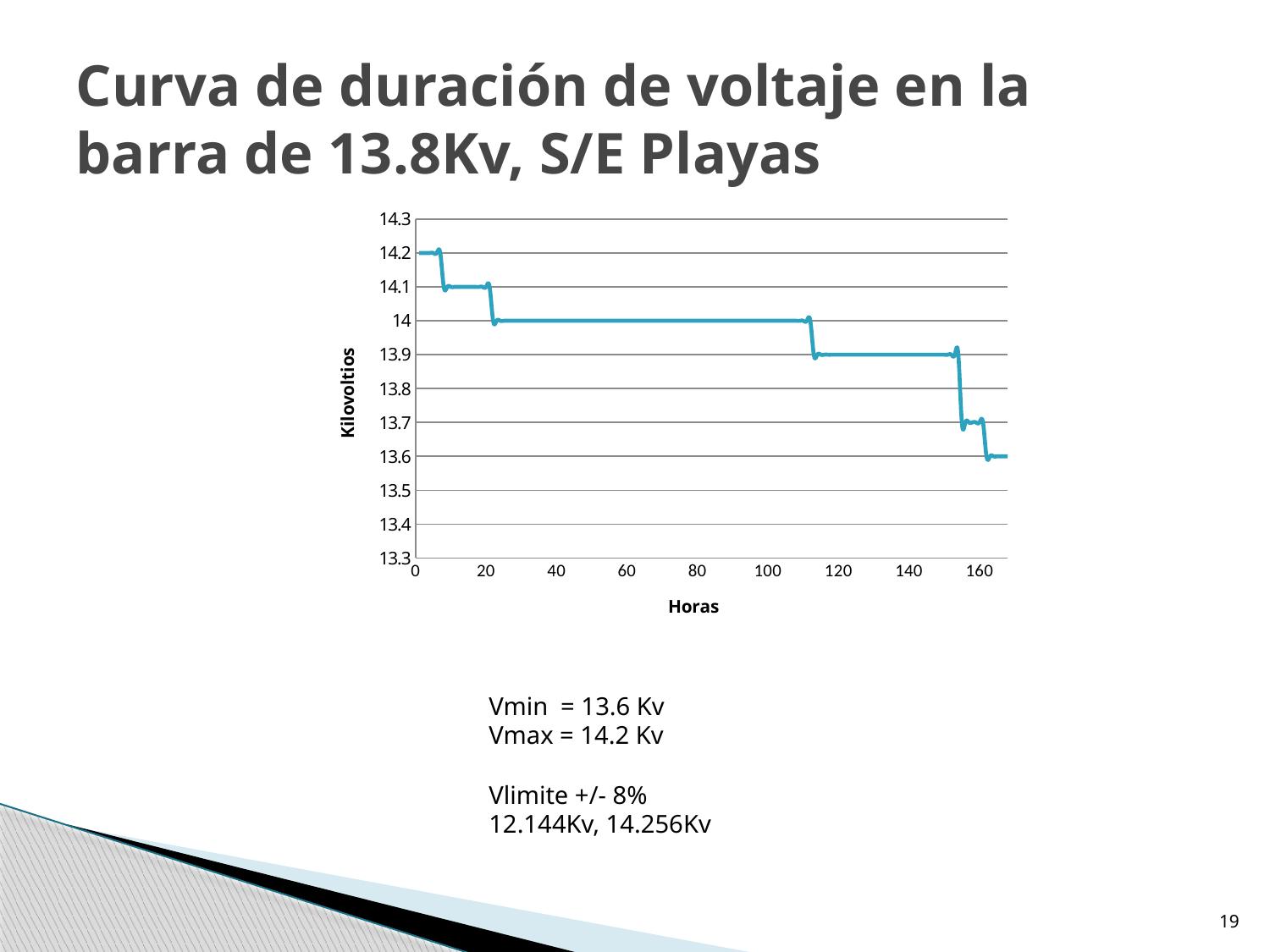
Is the voltage at 40 hours greater or less than the voltage at 120 hours? greater What voltage does the curve show at 60 hours? 14 What is the label of the x axis of the chart? Horas What is the label of the y axis of the chart? Kilovoltios What is the maximum voltage (Vmax) shown for the curve? 14.2 Kv What voltage does the curve show at 0 hours? 14.2 Is the voltage at 80 hours greater or less than 13.9? greater What is the difference between Vmax and Vmin on the curve? 0.6 Kv What kind of chart is shown on the slide? line chart What voltage does the curve show at 140 hours? 13.9 What is the minimum voltage (Vmin) shown for the curve? 13.6 Kv Do the voltage values rise or fall as the hours increase along the x axis? fall